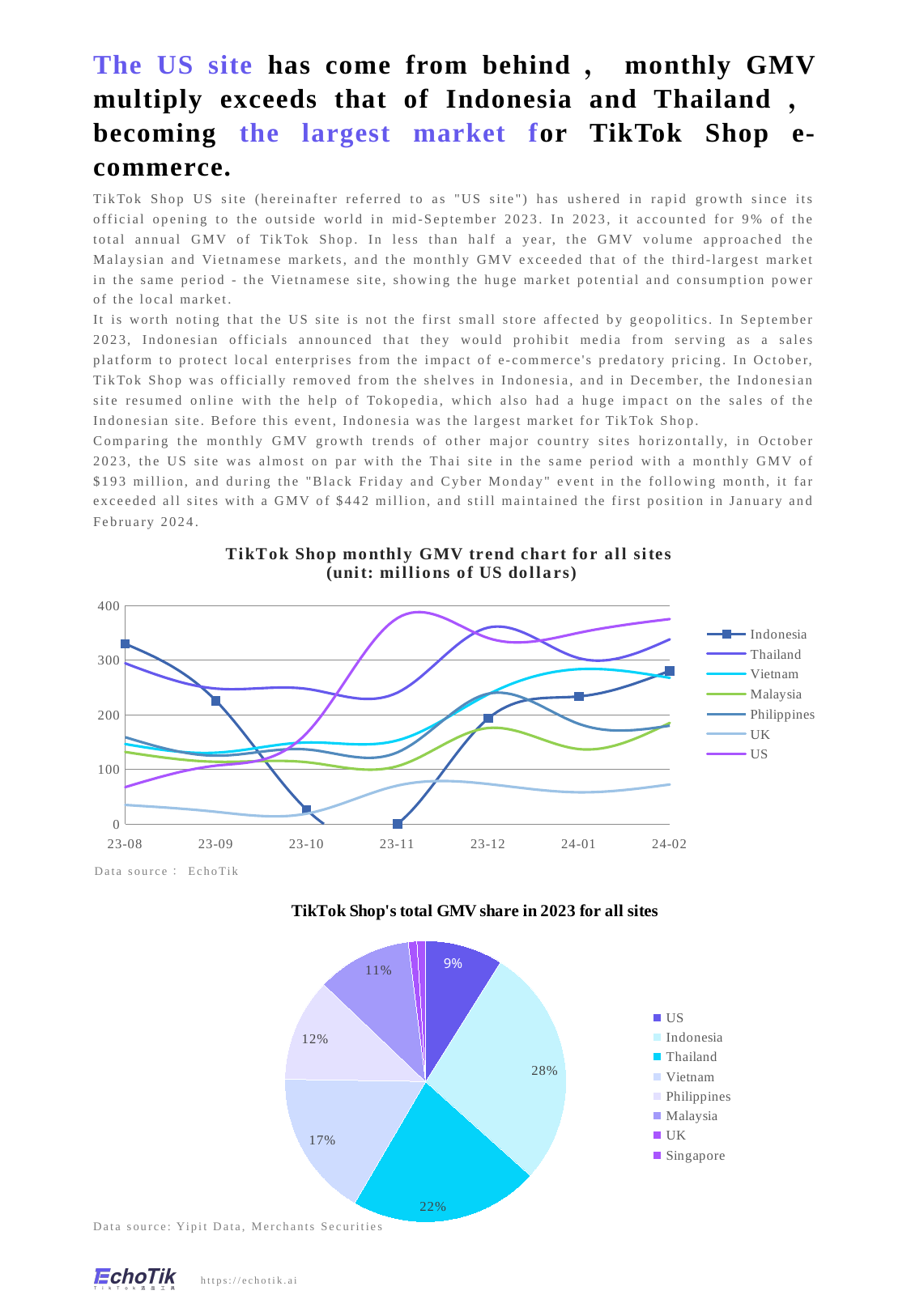
In the 'TikTok Shop monthly GMV trend chart for all sites', does the US series rise or fall from 23-08 to 23-11? rise In 'TikTok Shop's total GMV share in 2023 for all sites', which site has the largest share? Indonesia What kind of chart is the 'TikTok Shop monthly GMV trend chart for all sites'? line chart In the 'TikTok Shop monthly GMV trend chart for all sites', is the value for US at 23-11 greater or less than 300? greater In 'TikTok Shop's total GMV share in 2023 for all sites', what share does Indonesia have? 28% How many months are shown on the x axis of the 'TikTok Shop monthly GMV trend chart for all sites'? 7 How many series does the legend of the 'TikTok Shop monthly GMV trend chart for all sites' list? 7 What kind of chart is 'TikTok Shop's total GMV share in 2023 for all sites'? pie chart In the 'TikTok Shop monthly GMV trend chart for all sites', which series is higher at 24-02, US or UK? US In the 'TikTok Shop monthly GMV trend chart for all sites', is the value for UK at 23-08 greater or less than 100? less How many sites does the legend of 'TikTok Shop's total GMV share in 2023 for all sites' list? 8 In 'TikTok Shop's total GMV share in 2023 for all sites', what is the difference between the Indonesia share and the Thailand share? 6%